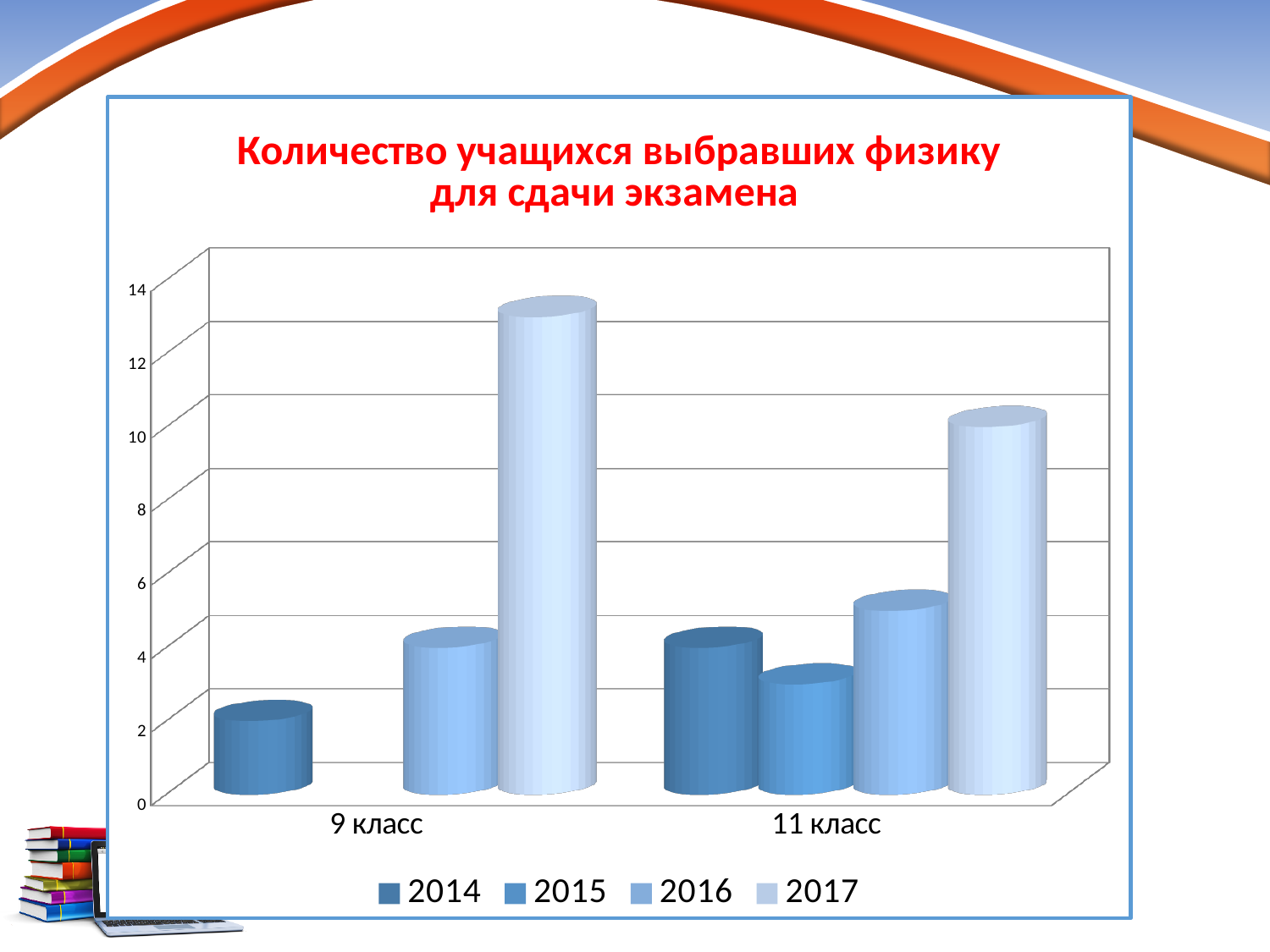
Is the value for 2017 in 11 класс greater or less than 8? greater What is the title of the chart? Количество учащихся выбравших физику для сдачи экзамена Is the value for 2014 in 9 класс greater or less than 4? less How many categories are shown on the x axis? 2 Which is larger: the 2014 value for 9 класс or the 2014 value for 11 класс? 11 класс What kind of chart is shown on the slide? bar chart Which year has the highest value for 11 класс? 2017 Is the value for 2017 in 9 класс greater or less than 12? greater Which year has the highest value for 9 класс? 2017 Which is larger: the 2017 value for 9 класс or the 2017 value for 11 класс? 9 класс Which year has the lowest value for 11 класс? 2015 How many series does the legend list? 4